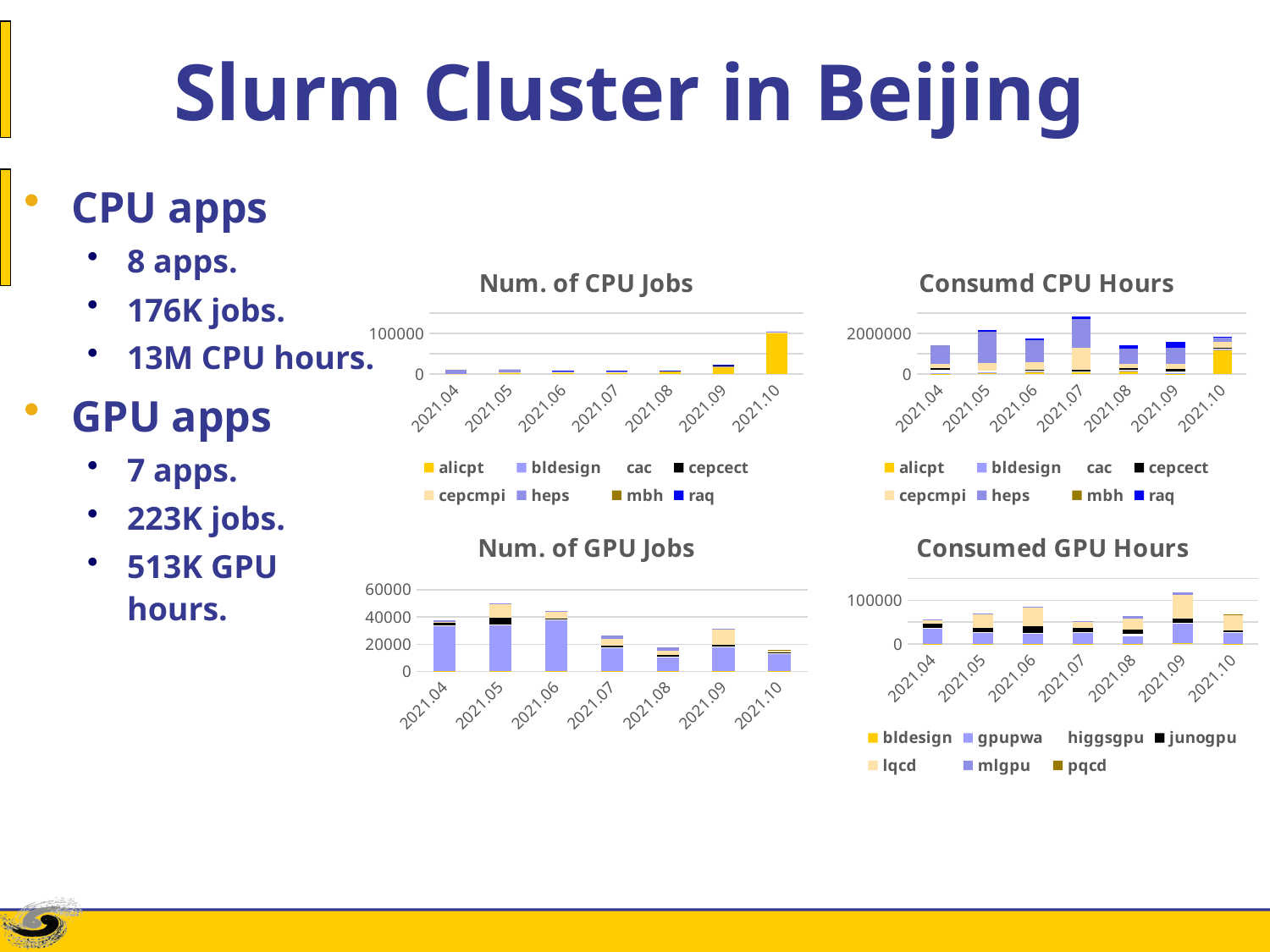
In the "Consumed GPU Hours" chart, is the total for 2021.04 greater or less than 100000? less In the "Num. of CPU Jobs" chart, which month has the larger total, 2021.09 or 2021.10? 2021.10 In the "Num. of GPU Jobs" chart, is the total for 2021.05 greater or less than 40000? greater How many series does the legend of the "Consumed GPU Hours" chart list? 7 How many months are shown on the x axis of the "Num. of GPU Jobs" chart? 7 In the "Consumd CPU Hours" chart, which month has the highest total? 2021.07 In the "Consumed GPU Hours" chart, which month has the highest total? 2021.09 In the "Num. of CPU Jobs" chart, which month has the highest total? 2021.10 What kind of chart is the "Num. of CPU Jobs" chart? Stacked bar chart In the "Consumd CPU Hours" chart, is the total for 2021.07 greater or less than 2000000? greater In the "Num. of GPU Jobs" chart, do the totals rise or fall from 2021.06 to 2021.08? fall How many series does the legend of the "Consumd CPU Hours" chart list? 8